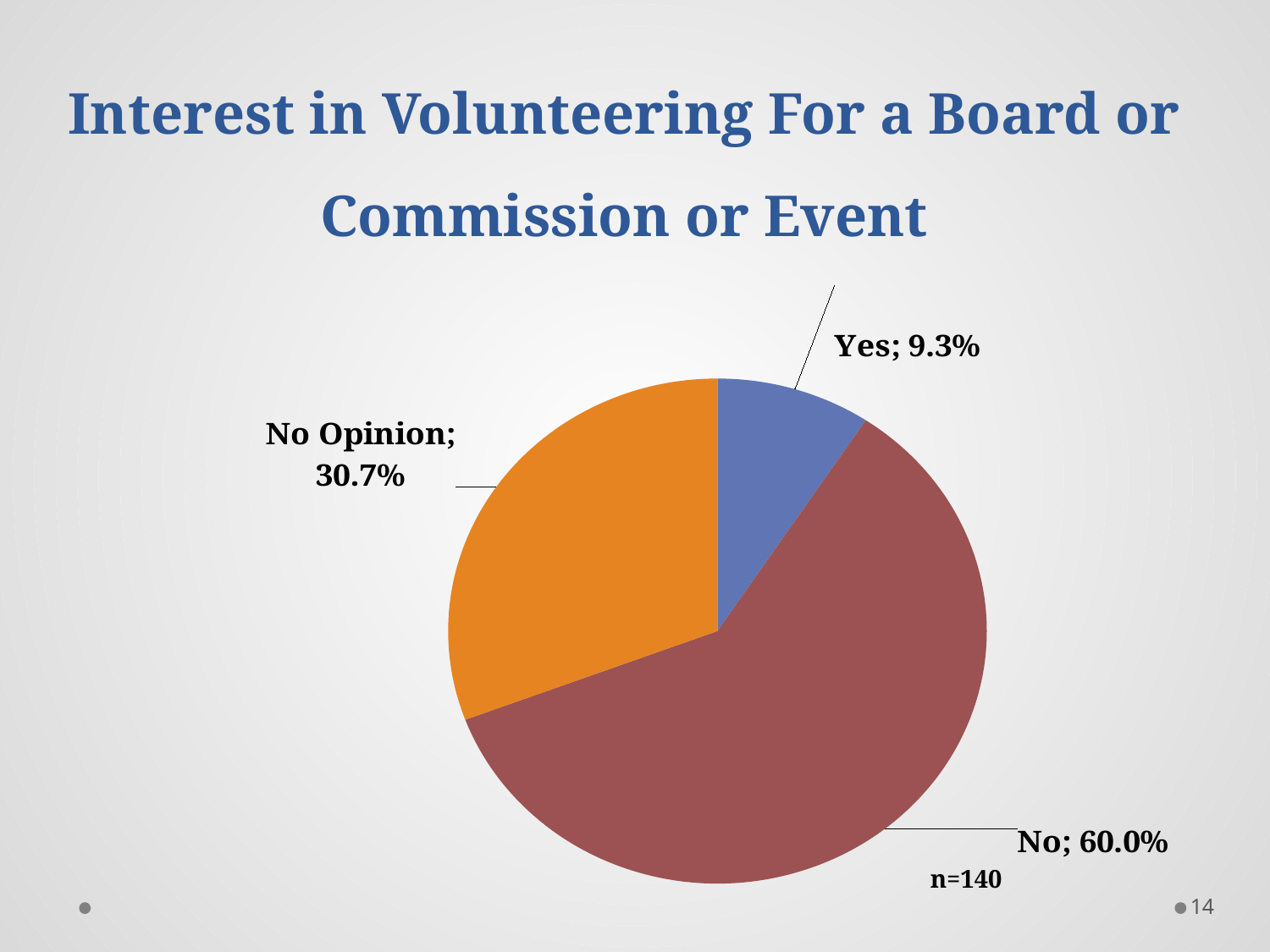
Which response has the largest share of the pie? No What is the difference in percentage points between "No" and "No Opinion"? 29.3 What kind of chart is shown on the slide? pie chart How many slices does the pie chart have? 3 What is the difference in percentage points between "No Opinion" and "Yes"? 21.4 Which is larger, the share for "No Opinion" or the share for "Yes"? No Opinion Which response has the smallest share of the pie? Yes What is the title of the chart on the slide? Interest in Volunteering For a Board or Commission or Event What is the sample size (n) shown on the slide? 140 What percentage of respondents answered "Yes"? 9.3% What percentage of respondents answered "No"? 60.0% What percentage of respondents had "No Opinion"? 30.7%